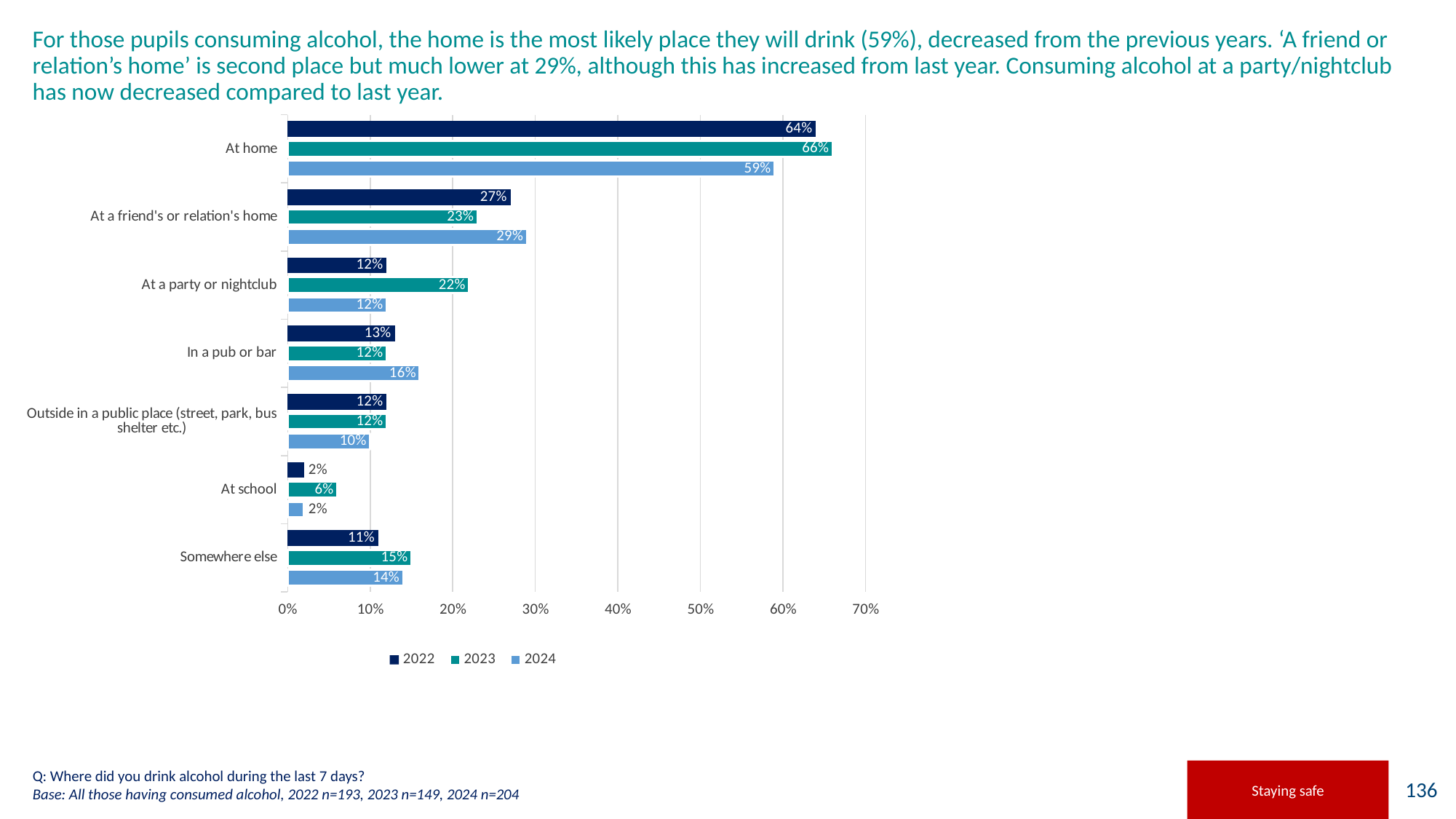
What is the survey question shown below the chart? Where did you drink alcohol during the last 7 days? What is the difference between the 2023 and 2024 values for 'At home'? 7% How many series does the legend list? 3 Which is larger for 'Somewhere else': the 2023 value or the 2024 value? 2023 What is the 2022 value for 'At a friend's or relation's home'? 27% Which category has the highest value in the 2024 series? At home What is the 2024 value for 'At home'? 59% How many categories are shown on the chart? 7 What is the 2024 value for 'In a pub or bar'? 16% Which category has the lowest value in the 2023 series? At school What is the 2023 value for 'At a party or nightclub'? 22% What kind of chart is shown on the slide? Bar chart